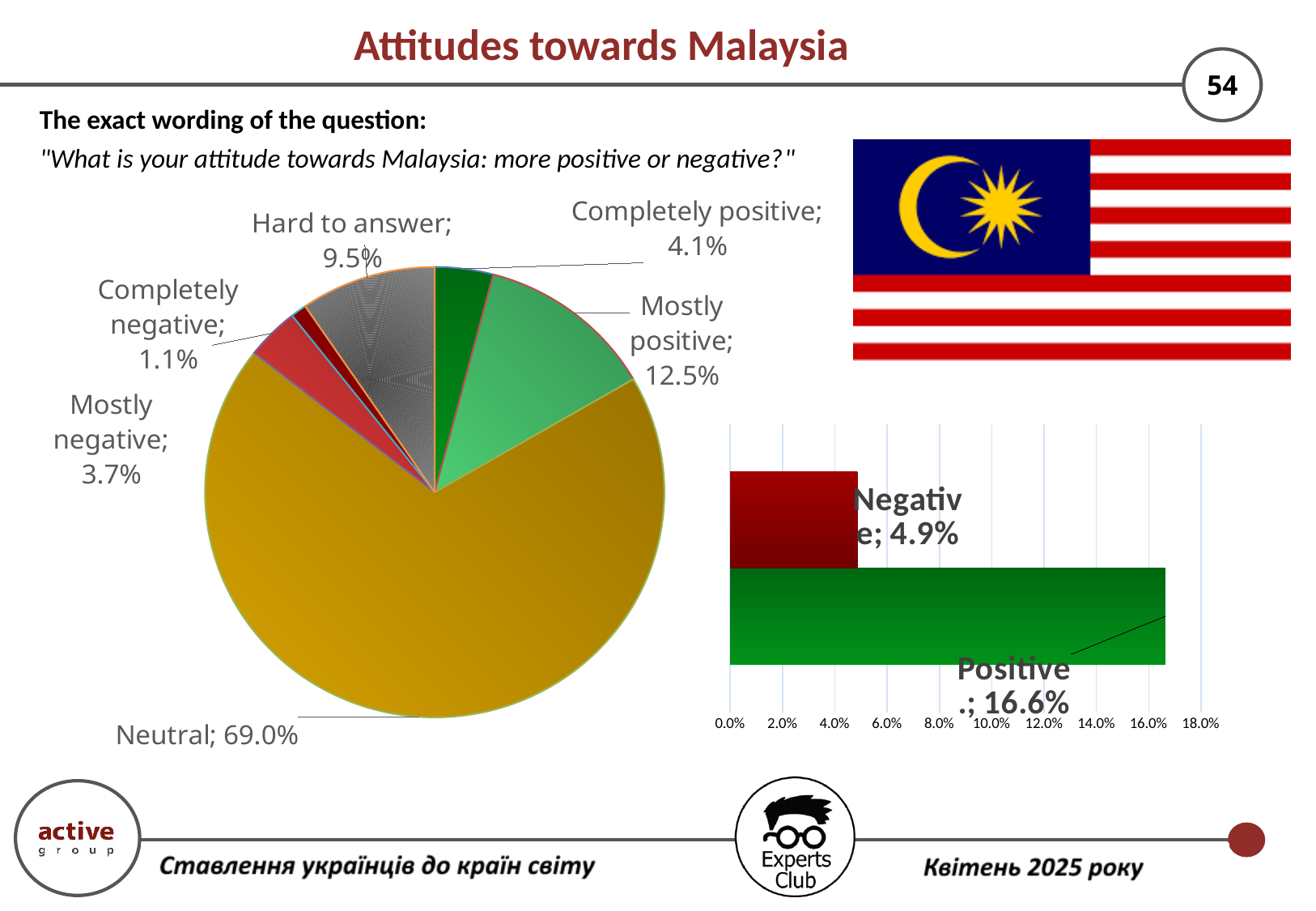
In the bar chart on the right, what is the value for "Negative"? 4.9% In the pie chart, what is the difference between "Mostly positive" and "Completely positive"? 8.4% In the pie chart, which category has the largest share? Neutral In the pie chart, which is larger: "Mostly negative" or "Completely positive"? Completely positive What type of chart is shown on the right side of the slide? Bar chart In the pie chart, what is the value for "Hard to answer"? 9.5% In the bar chart on the right, what is the value for "Positive"? 16.6% In the bar chart on the right, what is the difference between "Positive" and "Negative"? 11.7% In the pie chart, what share of respondents answered "Neutral"? 69.0% In the pie chart, which category has the smallest share? Completely negative In the pie chart, what is the value for "Mostly positive"? 12.5% How many categories does the pie chart show? 6